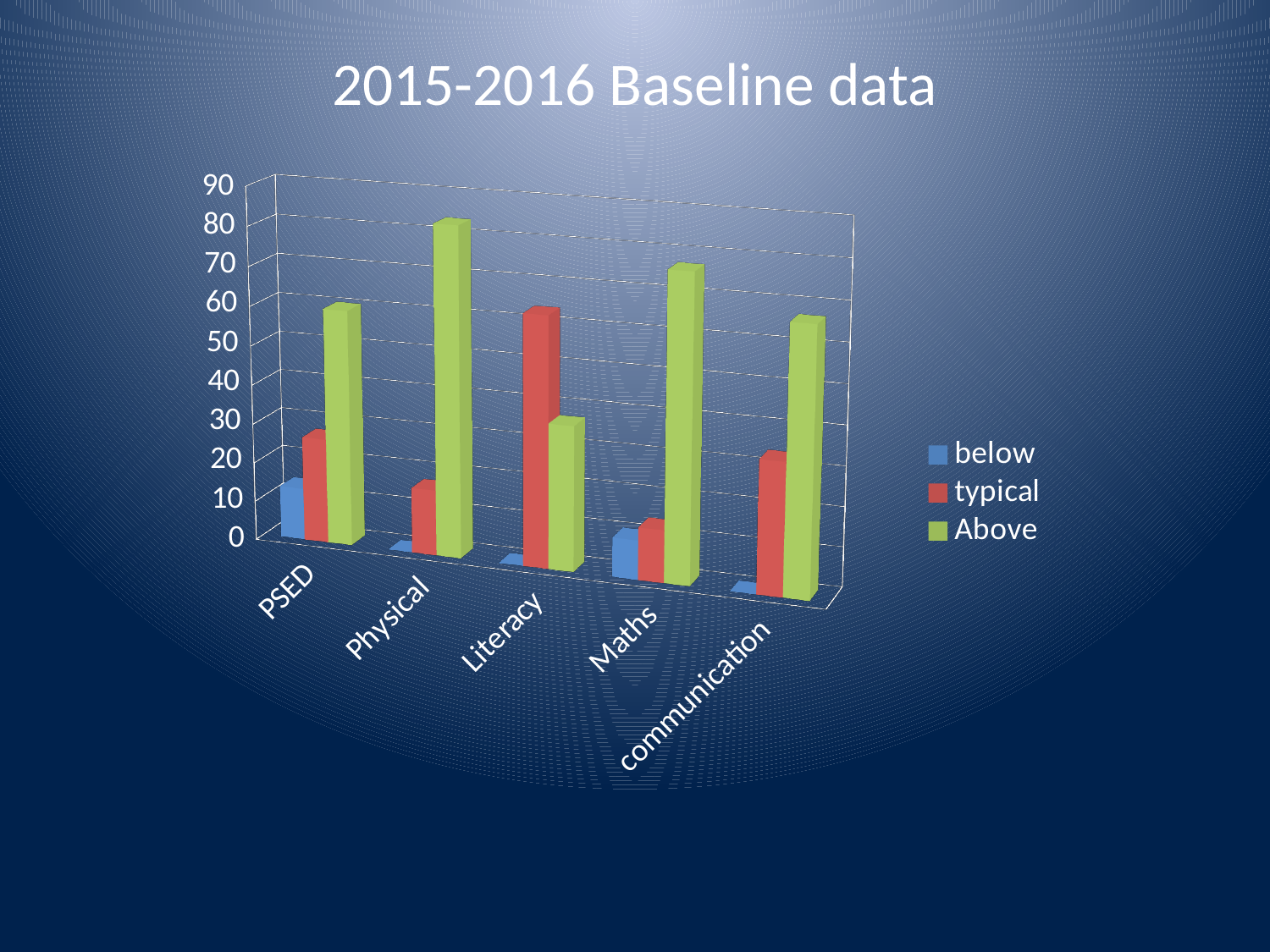
Is the typical value for Literacy greater or less than 40? greater What is the title of the chart? 2015-2016 Baseline data What kind of chart is shown on the slide? bar chart Is the Above value for Literacy greater or less than 40? less Which category has the highest value for the Above series? Physical For Literacy, which is larger: the typical value or the Above value? typical Which category has the lowest value for the Above series? Literacy Is the Above value for Physical greater or less than 70? greater How many categories are shown on the x axis of the chart? 5 Which series is shown in green in the chart? Above Which category has the highest value for the typical series? Literacy How many series does the chart's legend list? 3